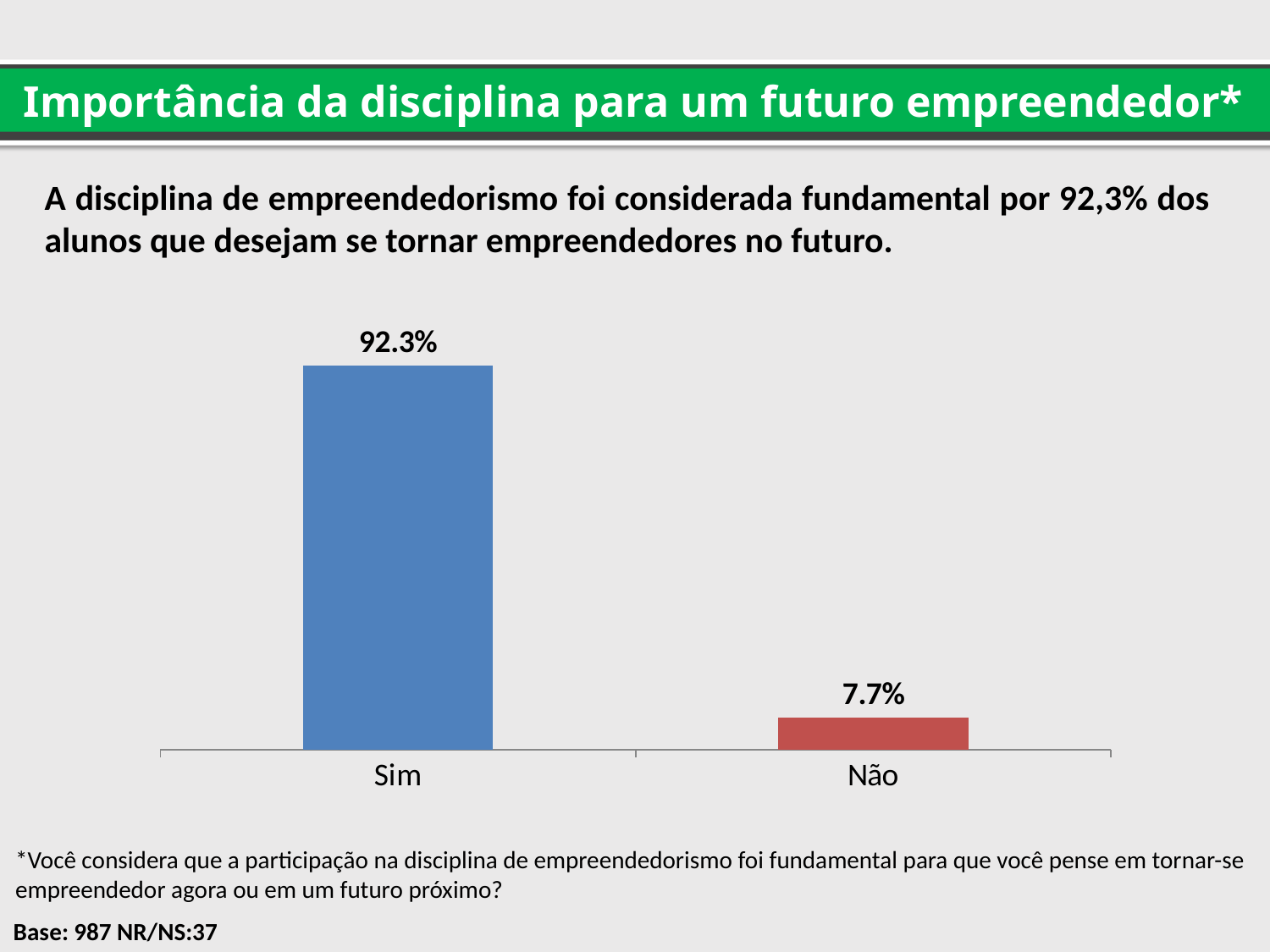
How many categories are shown on the chart? 2 What kind of chart is shown on the slide? Bar chart What colour is the bar for Não? Red What is the difference between the values for Sim and Não? 84.6% What is the value for Não? 7.7% What is the value for Sim? 92.3% Which category has the highest value? Sim Which is larger, the value for Sim or the value for Não? Sim What colour is the bar for Sim? Blue Which category has the lowest value? Não What is the total of the two values shown on the chart? 100%